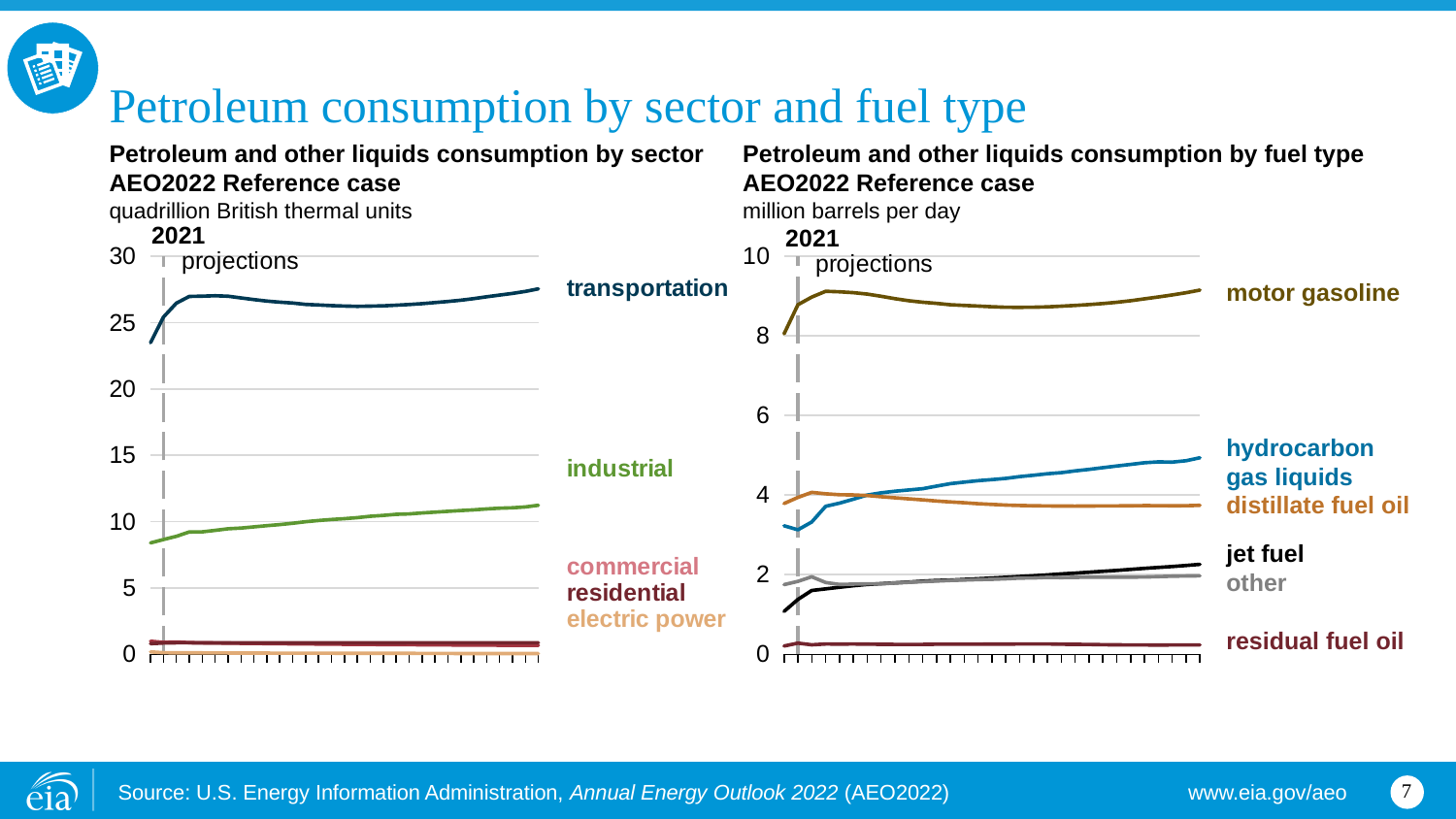
On the 'Petroleum and other liquids consumption by fuel type' chart, does the hydrocarbon gas liquids line rise or fall over the projection period? rise How many series are labelled on the 'Petroleum and other liquids consumption by fuel type' chart on the right? 6 On the 'Petroleum and other liquids consumption by fuel type' chart, is the value for residual fuel oil greater or less than 2? less On the 'Petroleum and other liquids consumption by sector' chart, which is larger, transportation or industrial? transportation On the 'Petroleum and other liquids consumption by sector' chart, is the value for transportation at the end of the projection period greater or less than 25? greater On the 'Petroleum and other liquids consumption by sector' chart, which sector has the highest consumption? transportation On the 'Petroleum and other liquids consumption by fuel type' chart, is the value for motor gasoline at the end of the projection period greater or less than 8? greater On the 'Petroleum and other liquids consumption by fuel type' chart, which fuel type has the highest consumption? motor gasoline What type of chart is the 'Petroleum and other liquids consumption by sector' chart on the left? line chart On the 'Petroleum and other liquids consumption by fuel type' chart, which fuel type has the lowest consumption? residual fuel oil What unit is used on the y axis of the 'Petroleum and other liquids consumption by fuel type' chart on the right? million barrels per day How many series are labelled on the 'Petroleum and other liquids consumption by sector' chart on the left? 5